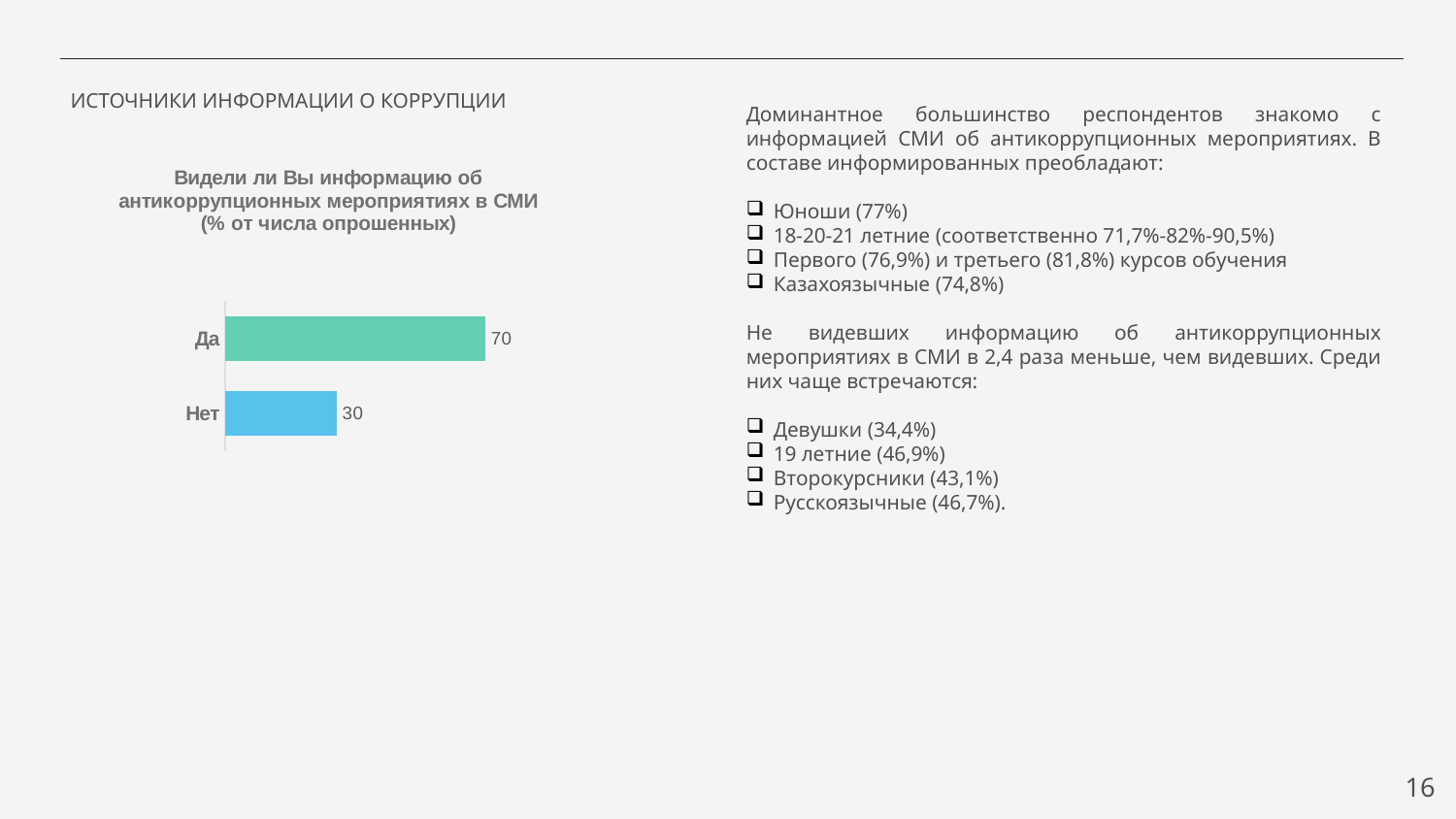
Which is larger, the value for "Да" or the value for "Нет"? Да What is the difference between the values for "Да" and "Нет"? 40 What colour is the bar for "Нет"? Blue How many categories are shown in the chart? 2 What kind of chart is shown on the slide? Bar chart What is the value for "Да" in the chart? 70 Which category has the highest value in the chart? Да Which category has the lowest value in the chart? Нет What is the total of the two values shown in the chart? 100 What is the value for "Нет" in the chart? 30 What is the title of the chart? Видели ли Вы информацию об антикоррупционных мероприятиях в СМИ (% от числа опрошенных)